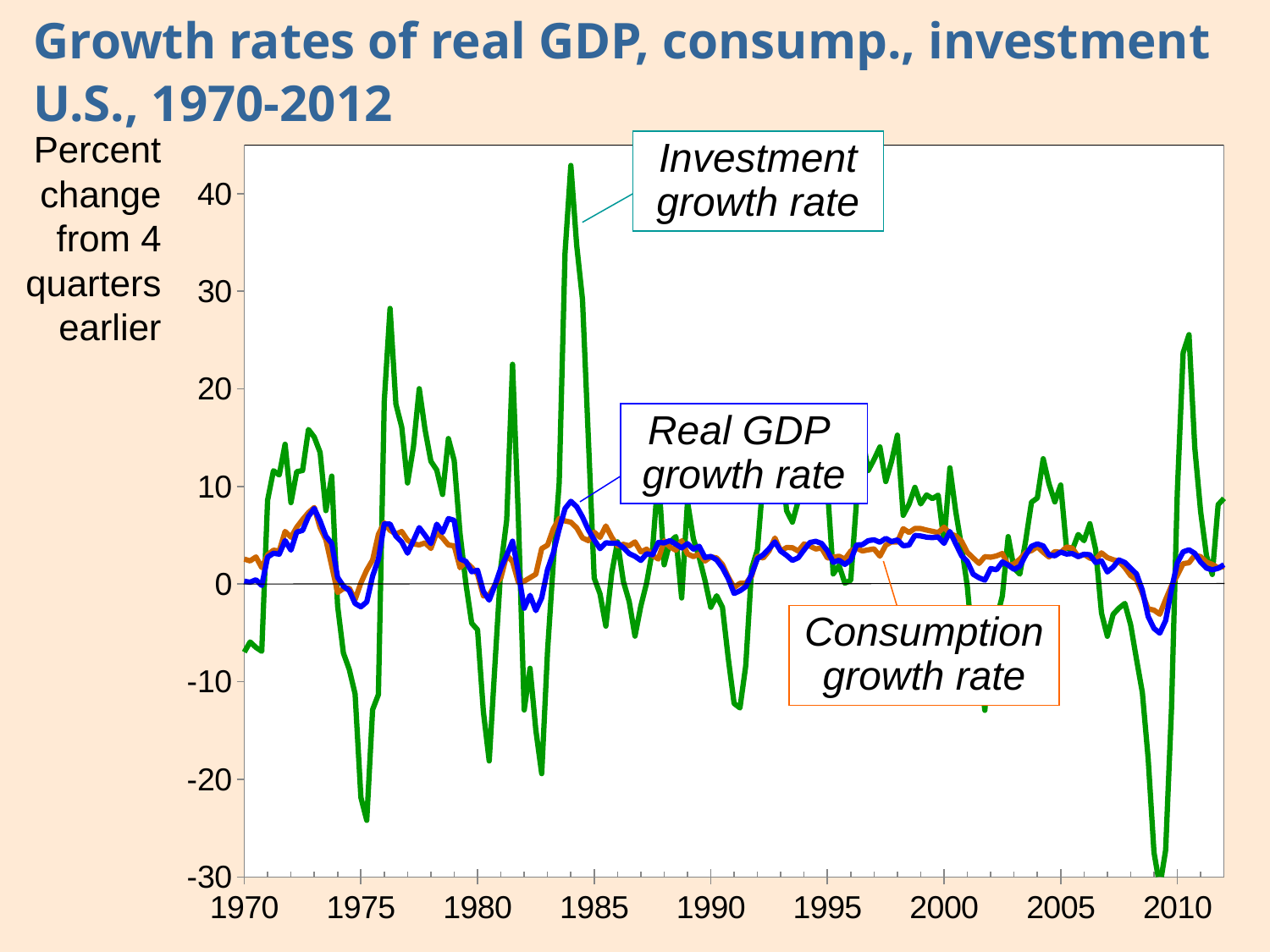
What is the highest value labeled on the vertical axis? 40 What kind of chart is shown on the slide? Line chart Is the lowest value of the investment growth rate around 2009 greater or less than -20? less Around 1984, which is larger: the investment growth rate or the real GDP growth rate? Investment growth rate Is the investment growth rate around 1975 greater or less than -20? less Which series reaches the lowest value on the chart? Investment growth rate How many series are plotted on the chart? 3 What is the title of the chart? Growth rates of real GDP, consump., investment U.S., 1970-2012 What is the first year labeled on the horizontal axis? 1970 Is the peak value of the investment growth rate around 1984 greater or less than 40? greater Which series reaches the highest value on the chart? Investment growth rate What does the vertical axis measure, according to the label on the slide? Percent change from 4 quarters earlier